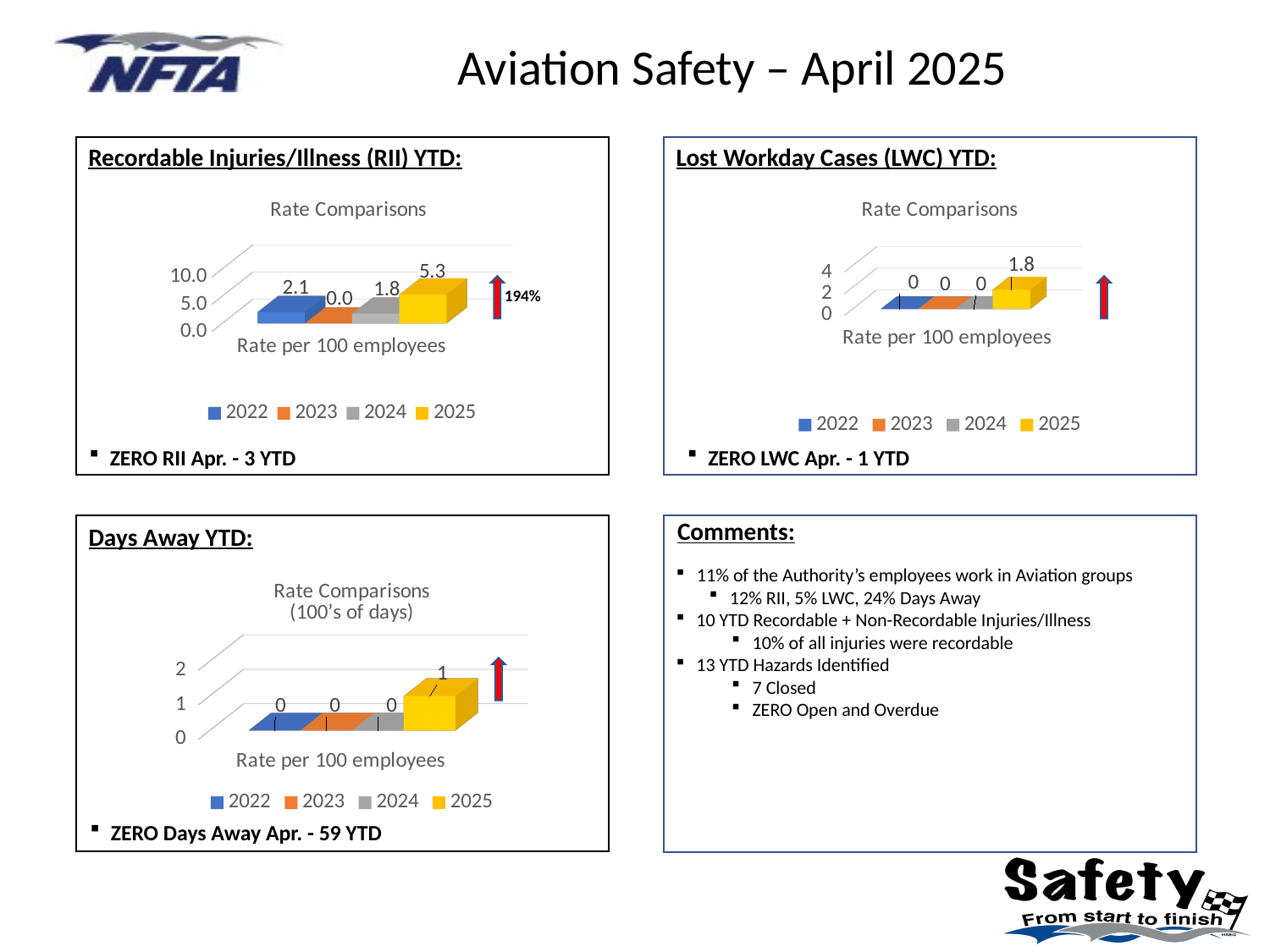
In the Recordable Injuries/Illness (RII) YTD chart, which year has the lowest rate? 2023 What kind of chart is the Lost Workday Cases (LWC) YTD chart? bar chart In the Recordable Injuries/Illness (RII) YTD chart, which year has the highest rate? 2025 In the Lost Workday Cases (LWC) YTD chart, what is the value for 2025? 1.8 In the Recordable Injuries/Illness (RII) YTD chart, what is the difference between the 2025 and 2024 values? 3.5 In the Recordable Injuries/Illness (RII) YTD chart, what is the value for 2022? 2.1 In the Days Away YTD chart, what is the value for 2025? 1 In the Recordable Injuries/Illness (RII) YTD chart, which is larger, the value for 2022 or the value for 2024? 2022 How many series does the legend of the Days Away YTD chart list? 4 In the Days Away YTD chart, what is the value for 2023? 0 In the Recordable Injuries/Illness (RII) YTD chart, what is the value for 2025? 5.3 In the Lost Workday Cases (LWC) YTD chart, is the value for 2025 greater or less than 2? less